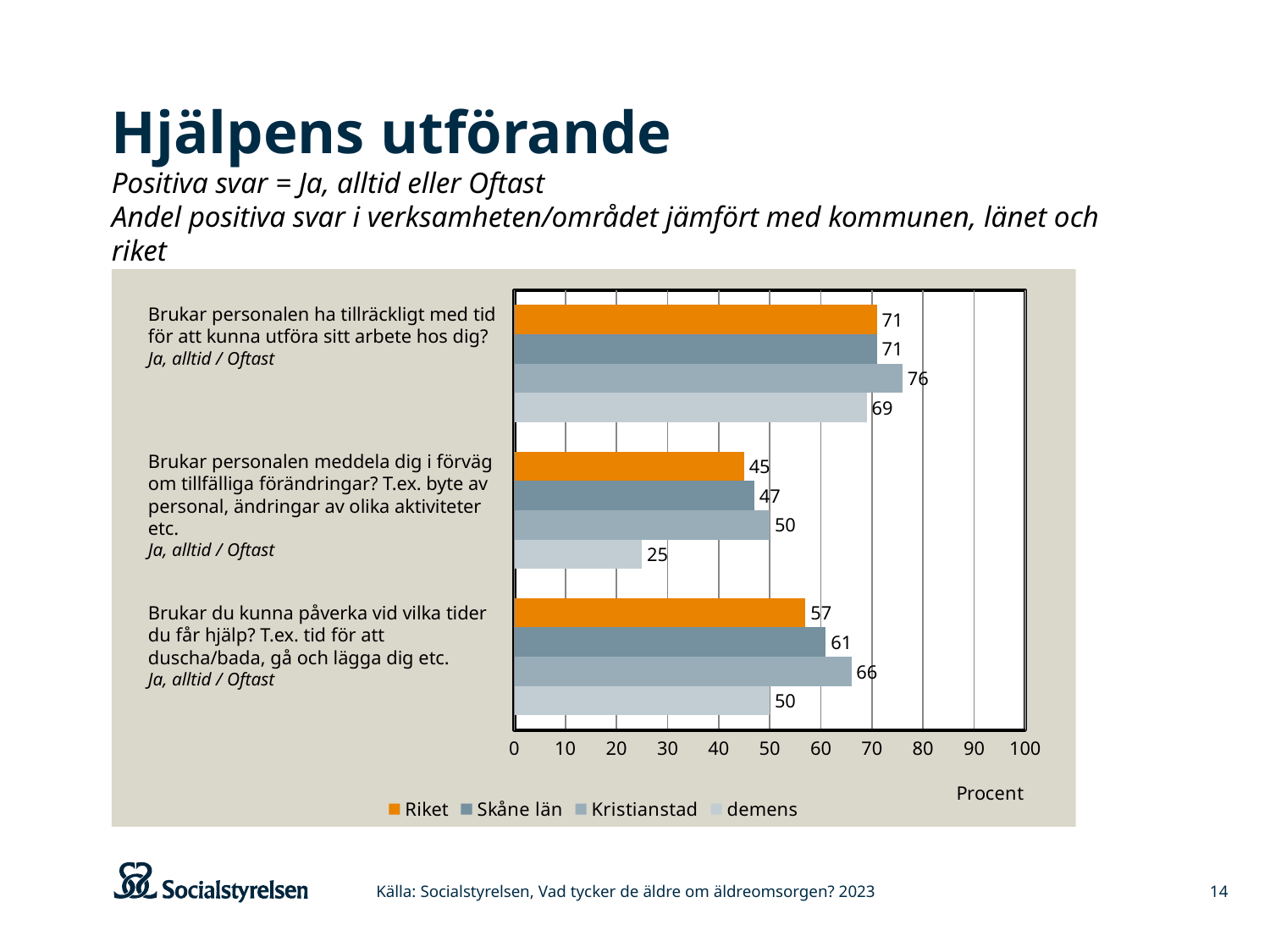
What kind of chart is shown on the slide? bar chart Which is larger on the question "Brukar du kunna påverka vid vilka tider du får hjälp?": Riket or demens? Riket How many series does the legend list? 4 Which series has the highest value on the question "Brukar du kunna påverka vid vilka tider du får hjälp?"? Kristianstad How many question categories are plotted in the chart? 3 What label is shown on the horizontal axis of the chart? Procent What is the difference between Kristianstad and Riket on the question "Brukar personalen ha tillräckligt med tid för att kunna utföra sitt arbete hos dig?"? 5 Which series has the lowest value on the question "Brukar personalen meddela dig i förväg om tillfälliga förändringar?"? demens What is the difference between Kristianstad and demens on the question "Brukar personalen meddela dig i förväg om tillfälliga förändringar?"? 25 What is the value for demens on the question "Brukar personalen meddela dig i förväg om tillfälliga förändringar?"? 25 What is the value for Kristianstad on the question "Brukar personalen ha tillräckligt med tid för att kunna utföra sitt arbete hos dig?"? 76 What is the value for Skåne län on the question "Brukar du kunna påverka vid vilka tider du får hjälp?"? 61